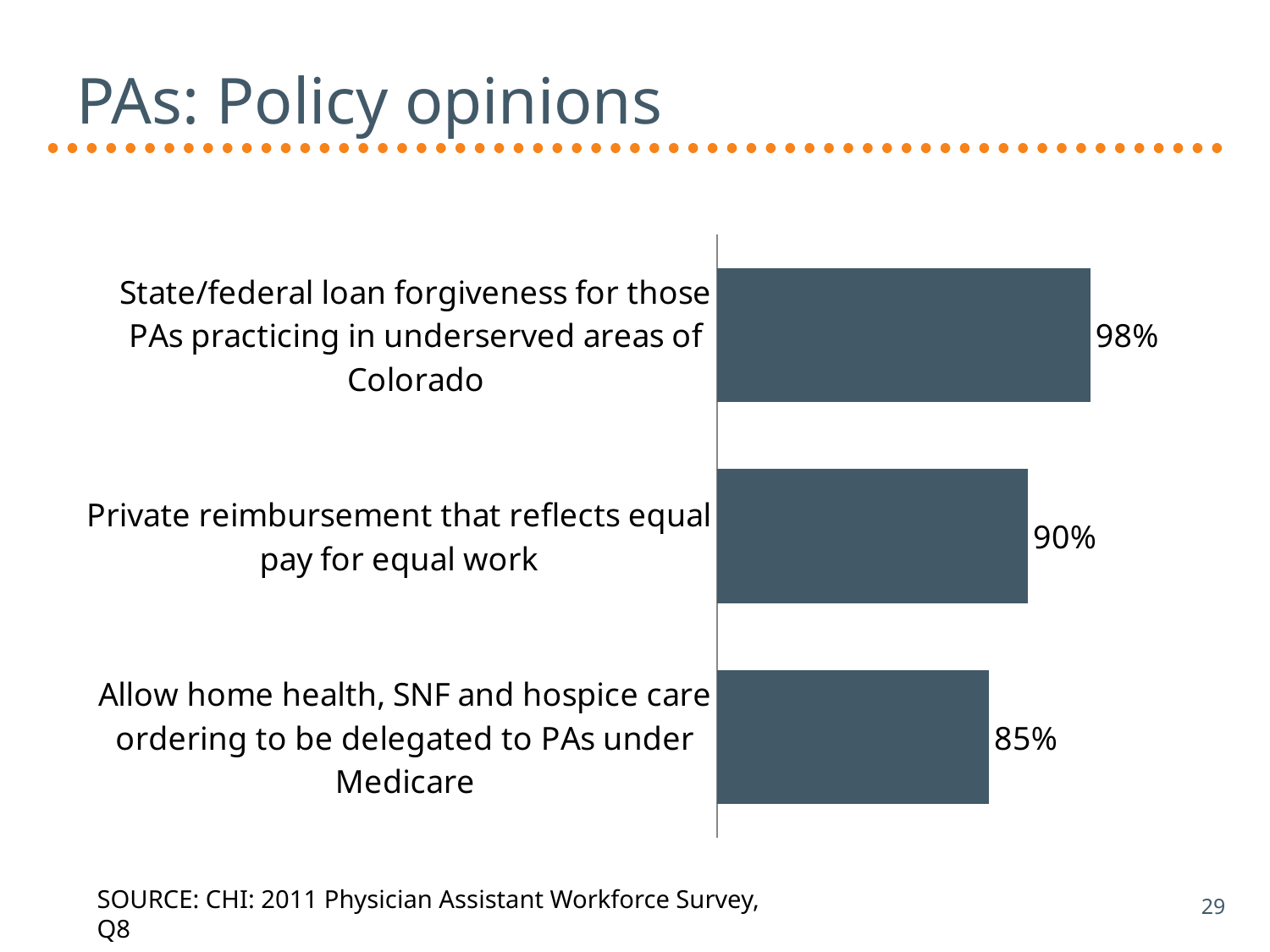
What is the difference between the value for loan forgiveness and the value for private reimbursement? 8% What is the value for allowing home health, SNF and hospice care ordering to be delegated to PAs under Medicare? 85% Which policy has the highest level of support? State/federal loan forgiveness for those PAs practicing in underserved areas of Colorado What kind of chart is shown on the slide? Bar chart What is the difference between the highest and lowest values on the chart? 13% How many policy categories are shown on the chart? 3 What is the value for private reimbursement that reflects equal pay for equal work? 90% What is the difference between the value for private reimbursement and the value for home health, SNF and hospice care ordering? 5% Which is larger: the value for private reimbursement or the value for home health, SNF and hospice care ordering? Private reimbursement that reflects equal pay for equal work What percentage of PAs support state/federal loan forgiveness for those PAs practicing in underserved areas of Colorado? 98% What is the title of the slide? PAs: Policy opinions Which policy has the lowest level of support? Allow home health, SNF and hospice care ordering to be delegated to PAs under Medicare